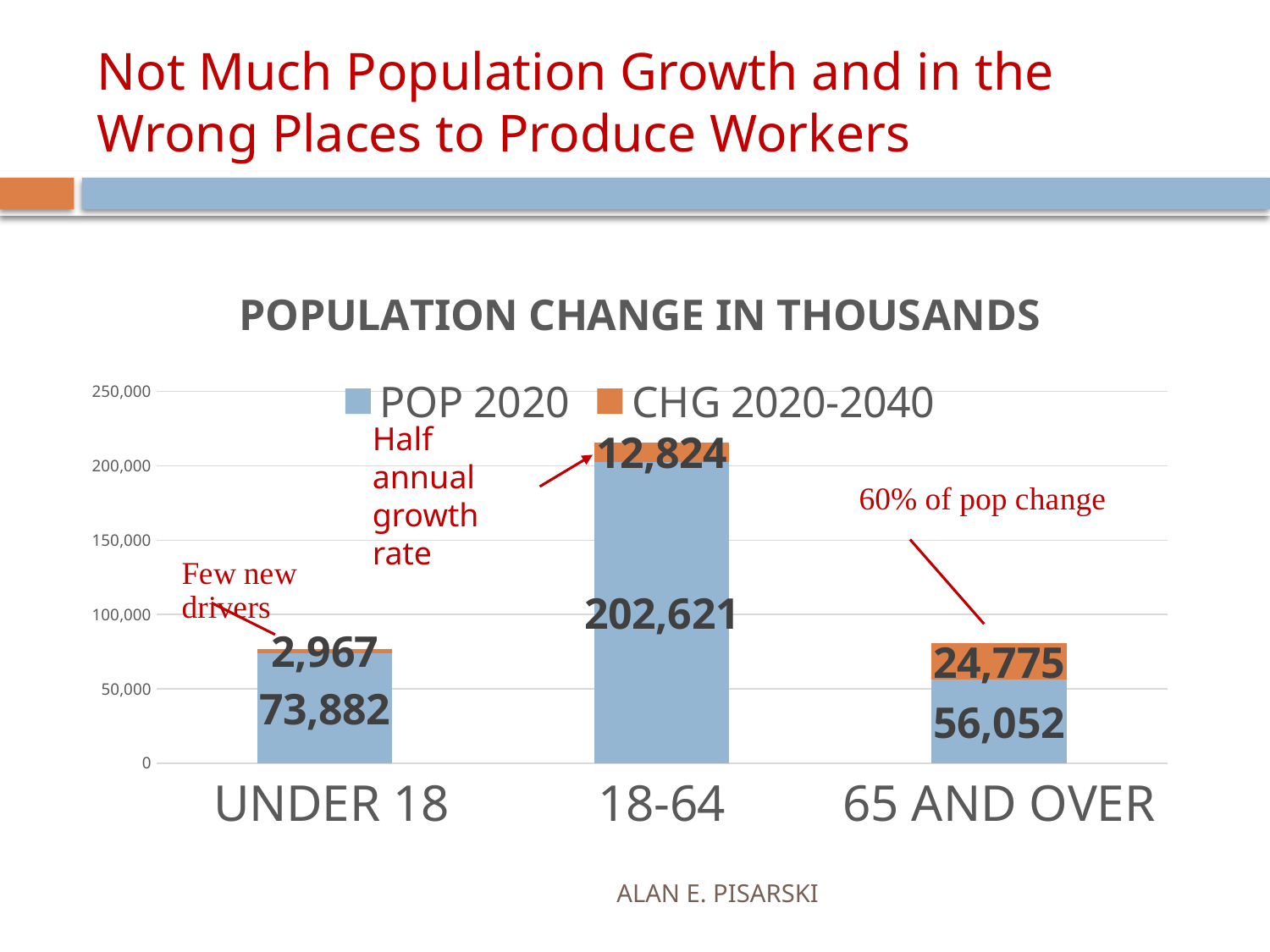
How many series does the legend list? 2 What is the difference between the POP 2020 values for 18-64 and UNDER 18? 128,739 Which is larger, the CHG 2020-2040 value for 18-64 or for 65 AND OVER? 65 AND OVER How many categories are shown on the x axis? 3 What is the CHG 2020-2040 value for the 65 AND OVER category? 24,775 What is the POP 2020 value for UNDER 18? 73,882 Which category has the lowest POP 2020 value? 65 AND OVER What is the total of the stacked bar for 65 AND OVER? 80,827 What is the total of the stacked bar for 18-64? 215,445 Which category has the highest CHG 2020-2040 value? 65 AND OVER What is the POP 2020 value for the 18-64 category? 202,621 What is the title of the chart? POPULATION CHANGE IN THOUSANDS